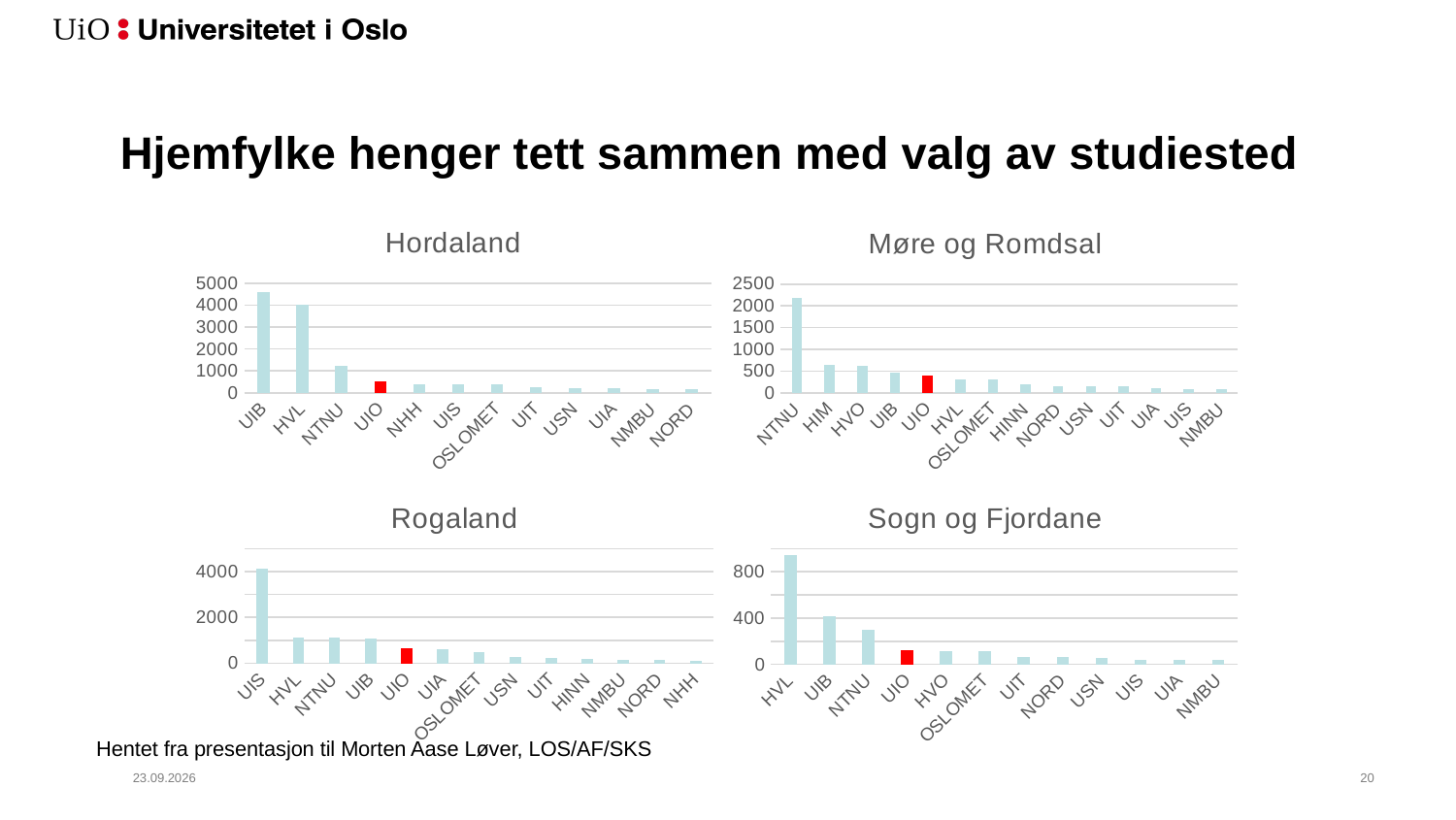
In the Sogn og Fjordane chart, do the values rise or fall from left to right along the x axis? fall In the Hordaland chart, is the value for UIO greater or less than 1000? less In the Hordaland chart, how many categories are shown on the x axis? 12 In the Møre og Romdsal chart, which category has the highest value? NTNU In the Hordaland chart, which category has the highest value? UIB In the Sogn og Fjordane chart, which category has the highest value? HVL In the Møre og Romdsal chart, how many categories are shown on the x axis? 14 How many charts are shown on the slide? 4 In the Hordaland chart, is the value for UIB greater or less than 4000? greater What kind of chart is the Hordaland chart? bar chart In the Rogaland chart, which is larger, the value for UIS or the value for UIO? UIS In the Møre og Romdsal chart, is the value for NTNU greater or less than 2000? greater